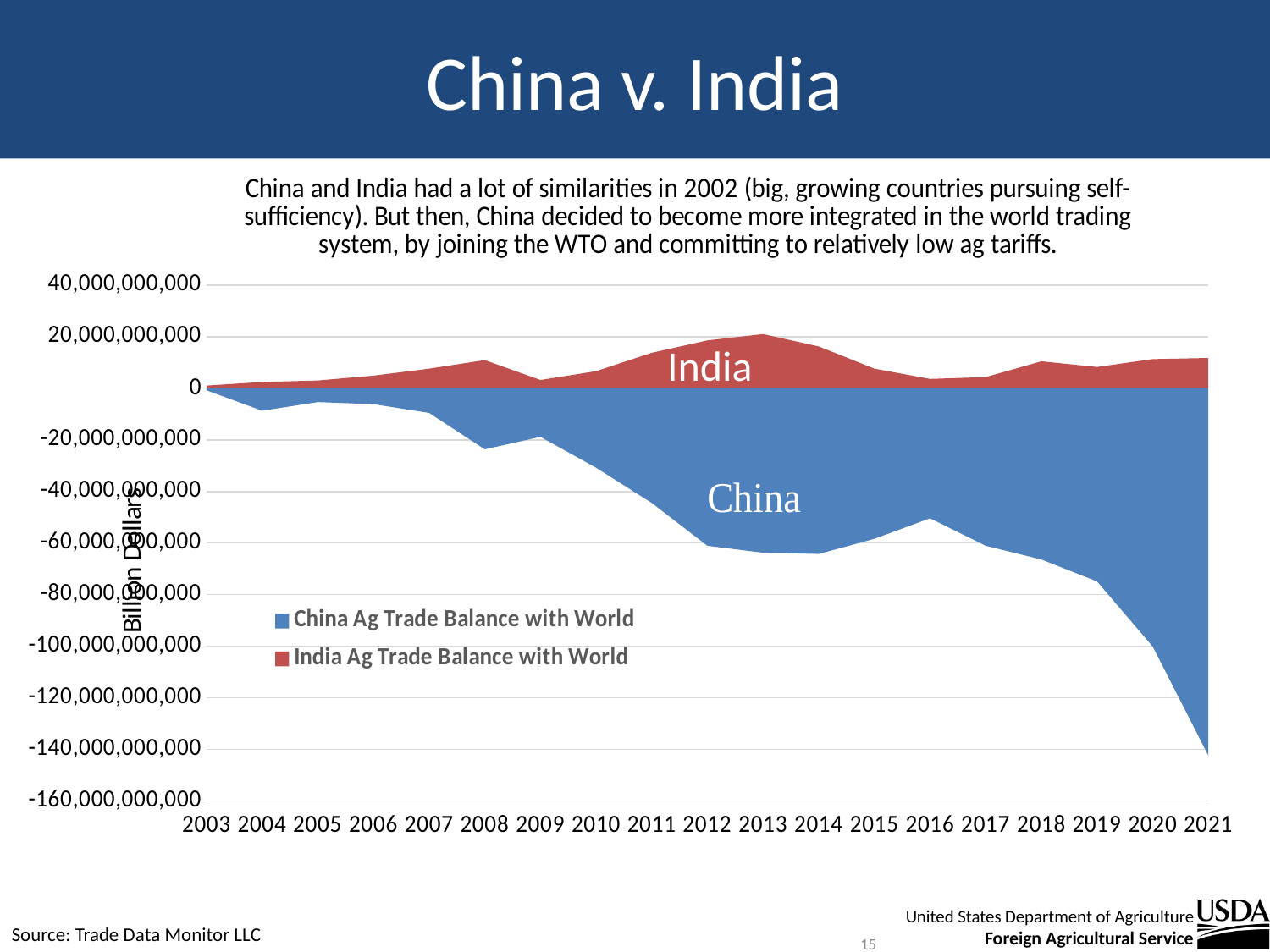
What kind of chart is shown on the slide? area chart In which year is the India Ag Trade Balance with World at its highest? 2013 Is the India Ag Trade Balance with World in 2013 greater or less than 0? greater Is the China Ag Trade Balance with World in 2021 greater or less than -120,000,000,000? less In which year is the China Ag Trade Balance with World at its lowest? 2021 Which series is shown in blue? China Ag Trade Balance with World Is the China Ag Trade Balance with World in 2012 greater or less than -40,000,000,000? less Does the China Ag Trade Balance with World generally rise or fall from 2003 to 2021? fall What is the label on the vertical axis? Billion Dollars How many series does the legend list? 2 Which is larger, the China Ag Trade Balance with World in 2003 or in 2021? 2003 How many years are shown along the x axis? 19